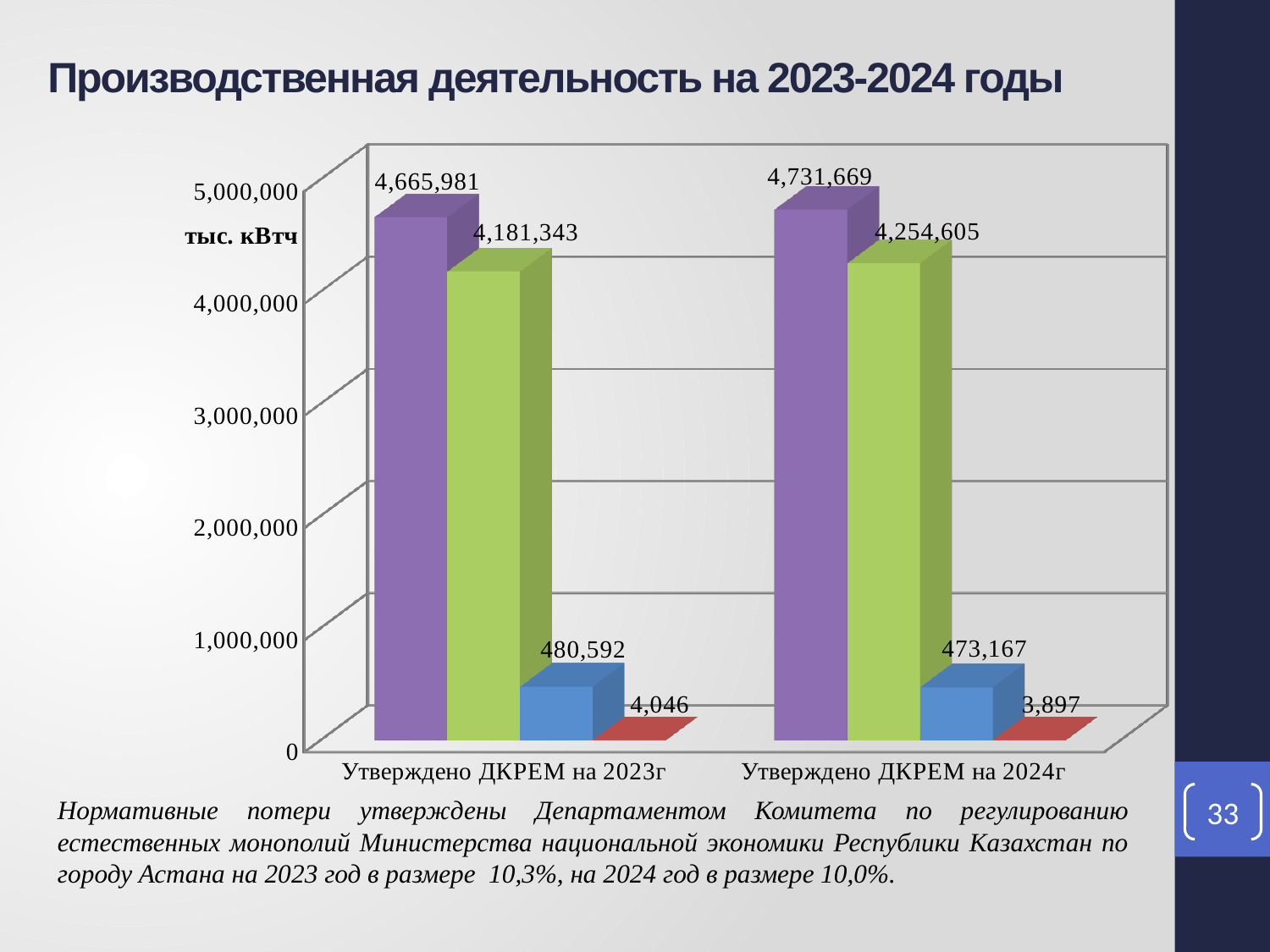
How many categories are shown on the x axis? 2 What is the value of the red bar for "Утверждено ДКРЕМ на 2023г"? 4,046 What is the difference between the green bar values for 2024 (4,254,605) and 2023 (4,181,343)? 73,262 What is the value of the blue bar for "Утверждено ДКРЕМ на 2024г"? 473,167 Which bar has the highest value on the chart? the purple bar for Утверждено ДКРЕМ на 2024г (4,731,669) What unit label is shown next to the vertical axis? тыс. кВтч What type of chart is shown on the slide? bar chart What is the value of the purple bar for "Утверждено ДКРЕМ на 2023г"? 4,665,981 What is the value of the green bar for "Утверждено ДКРЕМ на 2023г"? 4,181,343 What is the value of the purple bar for "Утверждено ДКРЕМ на 2024г"? 4,731,669 Which bar has the lowest value on the chart? the red bar for Утверждено ДКРЕМ на 2024г (3,897) Is the blue bar for "Утверждено ДКРЕМ на 2023г" larger or smaller than the blue bar for "Утверждено ДКРЕМ на 2024г"? larger